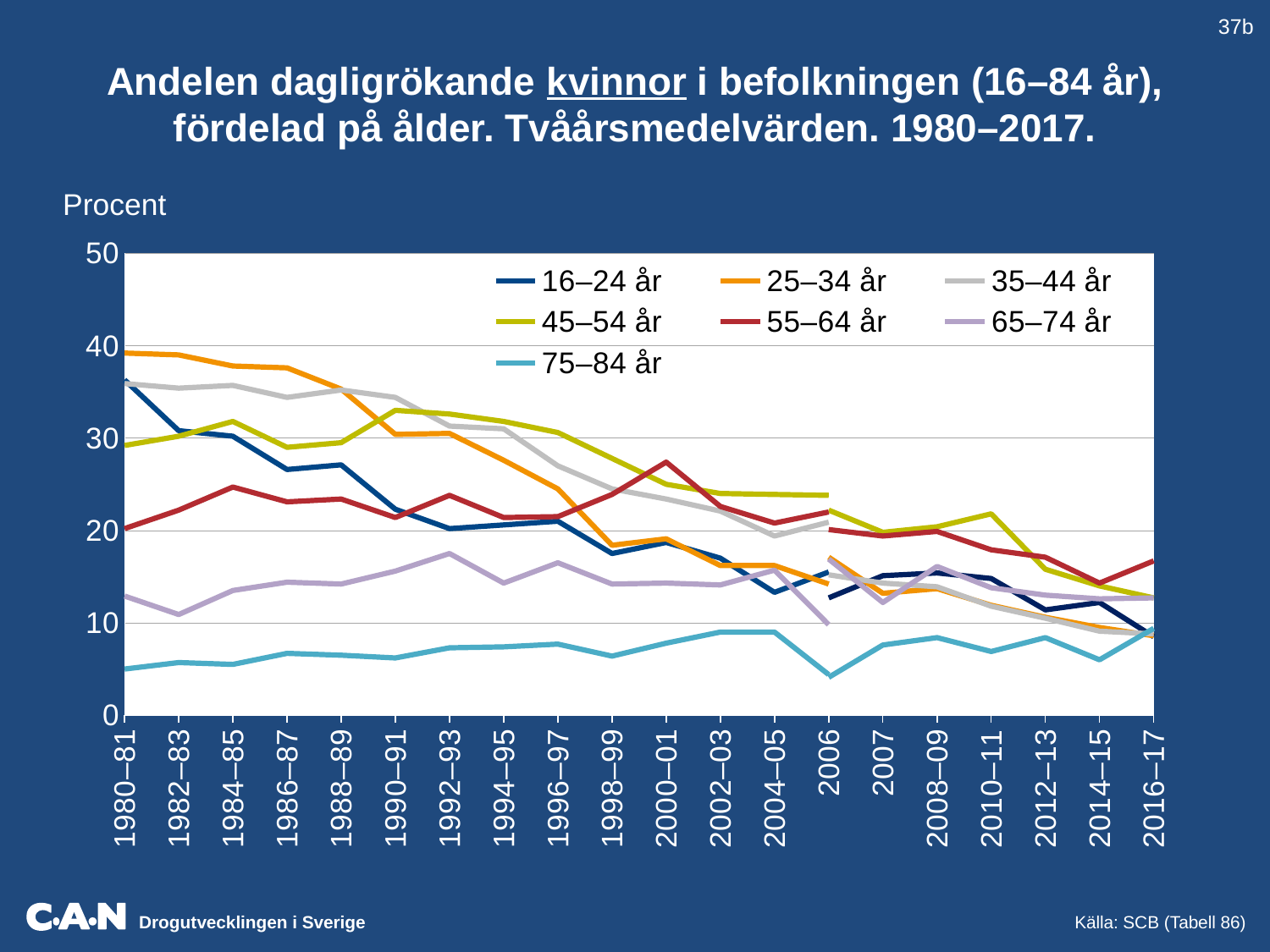
Is the value for 55–64 år in 2000–01 greater or less than 20? greater What unit is shown on the y axis label? Procent Which age group has the highest value in 2016–17? 55–64 år Which age group has the lowest value in 1980–81? 75–84 år How many series does the legend list? 7 Is the value for 25–34 år in 1980–81 greater or less than 30? greater Does the value for 25–34 år rise or fall from 1980–81 to 2016–17? fall How many time periods are shown on the x axis? 20 Is the value for 75–84 år in 2006 greater or less than 10? less Which is larger in 1980–81, the value for 25–34 år or the value for 55–64 år? 25–34 år Which age group has the highest value in 1980–81? 25–34 år What kind of chart is shown on the slide? line chart